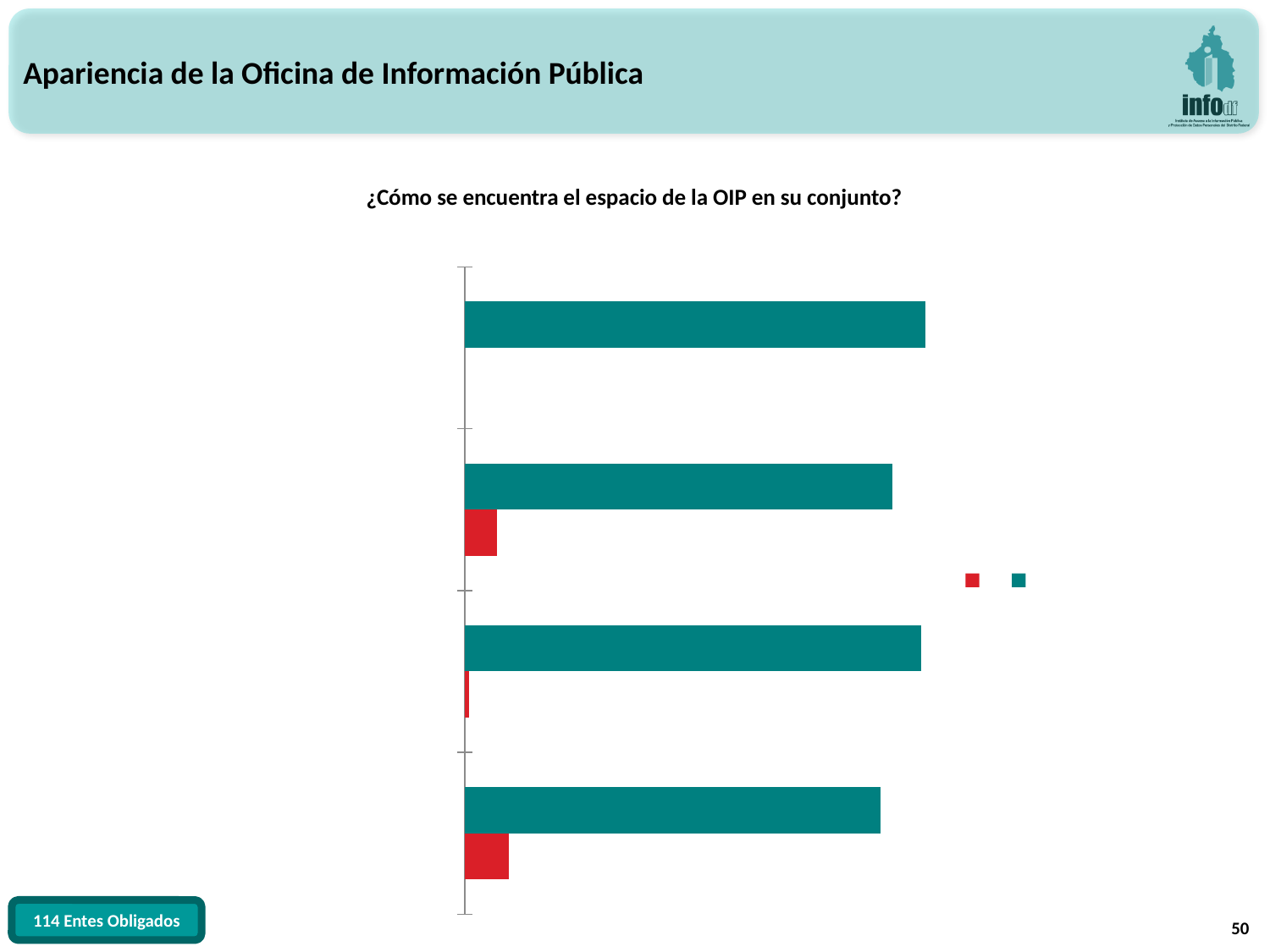
How many category groups of bars are plotted on the chart? 4 Are the bars in the chart horizontal or vertical? horizontal In every category group, which series has the longer bar, the red one or the teal one? teal What kind of chart is shown on the slide? bar chart How many series does the legend list? 2 What two colours are used for the series in the chart? red and teal What is the title of the chart? ¿Cómo se encuentra el espacio de la OIP en su conjunto?